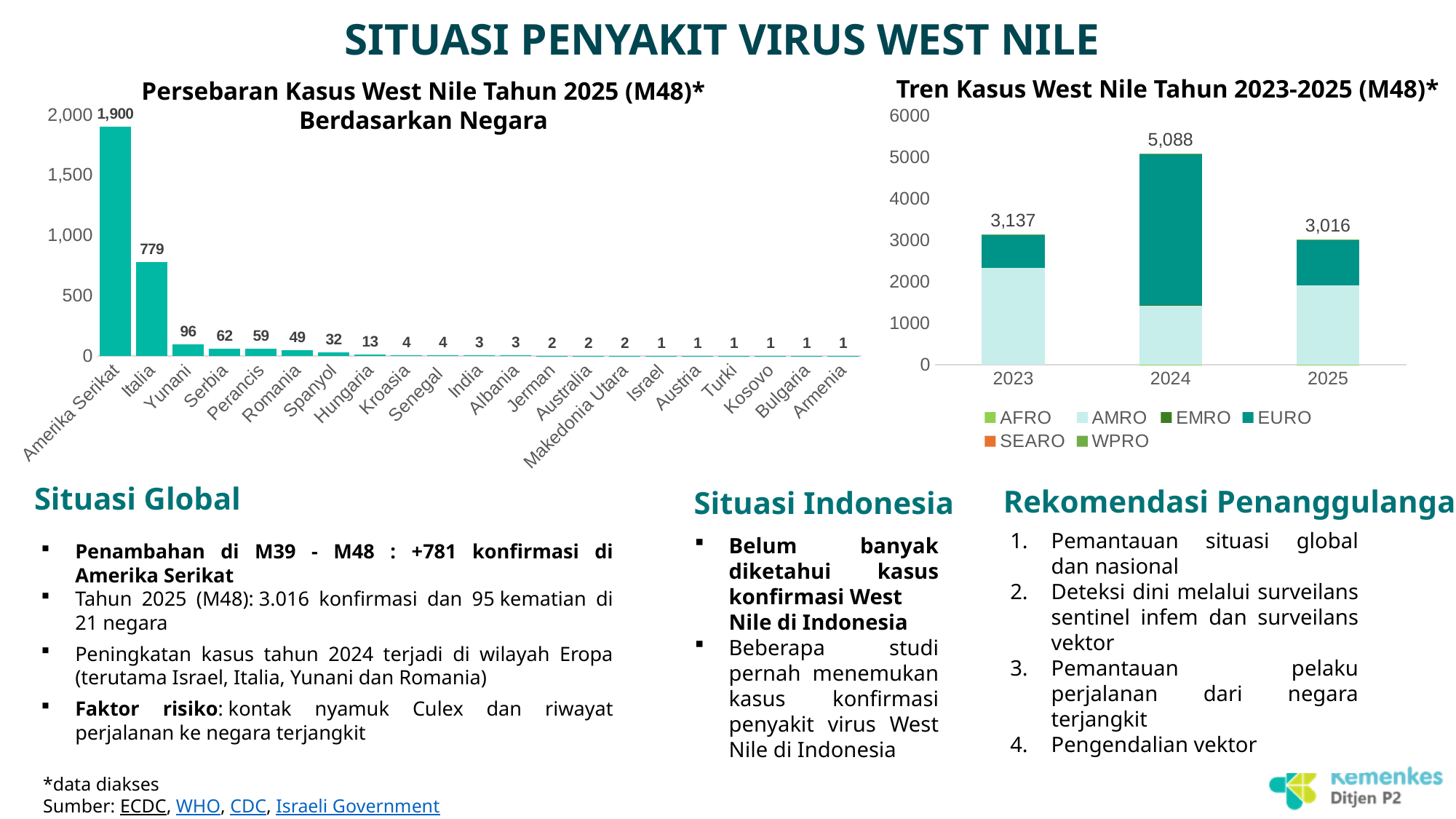
In the chart 'Tren Kasus West Nile Tahun 2023-2025 (M48)*', what is the difference between the totals for 2024 and 2025? 2,072 In the chart 'Tren Kasus West Nile Tahun 2023-2025 (M48)*', how many series does the legend list? 6 In the chart 'Tren Kasus West Nile Tahun 2023-2025 (M48)*', what is the total for 2024? 5,088 In the chart 'Persebaran Kasus West Nile Tahun 2025 (M48)* Berdasarkan Negara', what is the value for Amerika Serikat? 1,900 In the chart 'Tren Kasus West Nile Tahun 2023-2025 (M48)*', which year has the highest total? 2024 In the chart 'Persebaran Kasus West Nile Tahun 2025 (M48)* Berdasarkan Negara', which country has the highest value? Amerika Serikat In the chart 'Tren Kasus West Nile Tahun 2023-2025 (M48)*', is the AMRO value for 2024 greater or less than 2000? less In the chart 'Persebaran Kasus West Nile Tahun 2025 (M48)* Berdasarkan Negara', what is the value for Italia? 779 In the chart 'Persebaran Kasus West Nile Tahun 2025 (M48)* Berdasarkan Negara', how many countries are shown on the x axis? 21 What kind of chart is 'Persebaran Kasus West Nile Tahun 2025 (M48)* Berdasarkan Negara'? bar chart In the chart 'Persebaran Kasus West Nile Tahun 2025 (M48)* Berdasarkan Negara', which is larger, the value for Yunani or the value for Serbia? Yunani In the chart 'Persebaran Kasus West Nile Tahun 2025 (M48)* Berdasarkan Negara', what is the difference between the values for Amerika Serikat and Italia? 1,121